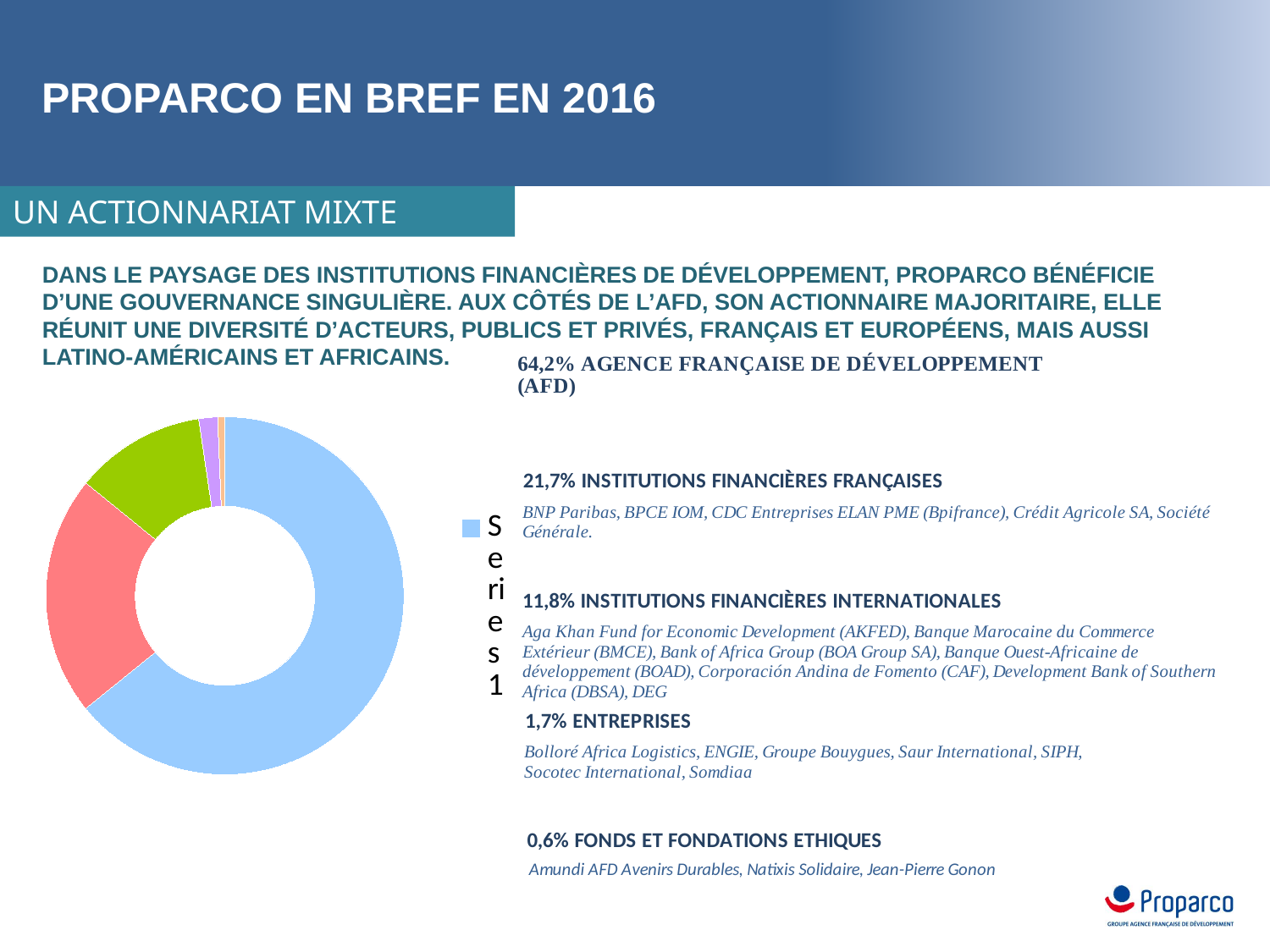
How many series does the chart legend list? 1 What colour is the largest slice of the doughnut chart? Light blue What share of the shareholding is held by the Agence Française de Développement (AFD)? 64,2% Which shareholder category holds the largest share of the doughnut chart? Agence Française de Développement (AFD) Which shareholder category holds the smallest share of the doughnut chart? Fonds et fondations éthiques What share of the shareholding is held by the Institutions financières internationales? 11,8% Which is larger: the share of the Institutions financières françaises or the share of the Institutions financières internationales? Institutions financières françaises What is the legend entry shown next to the doughnut chart? Series1 How many slices does the doughnut chart have? 5 What share of the shareholding is held by Entreprises? 1,7% What kind of chart is shown on the slide? Doughnut (pie) chart